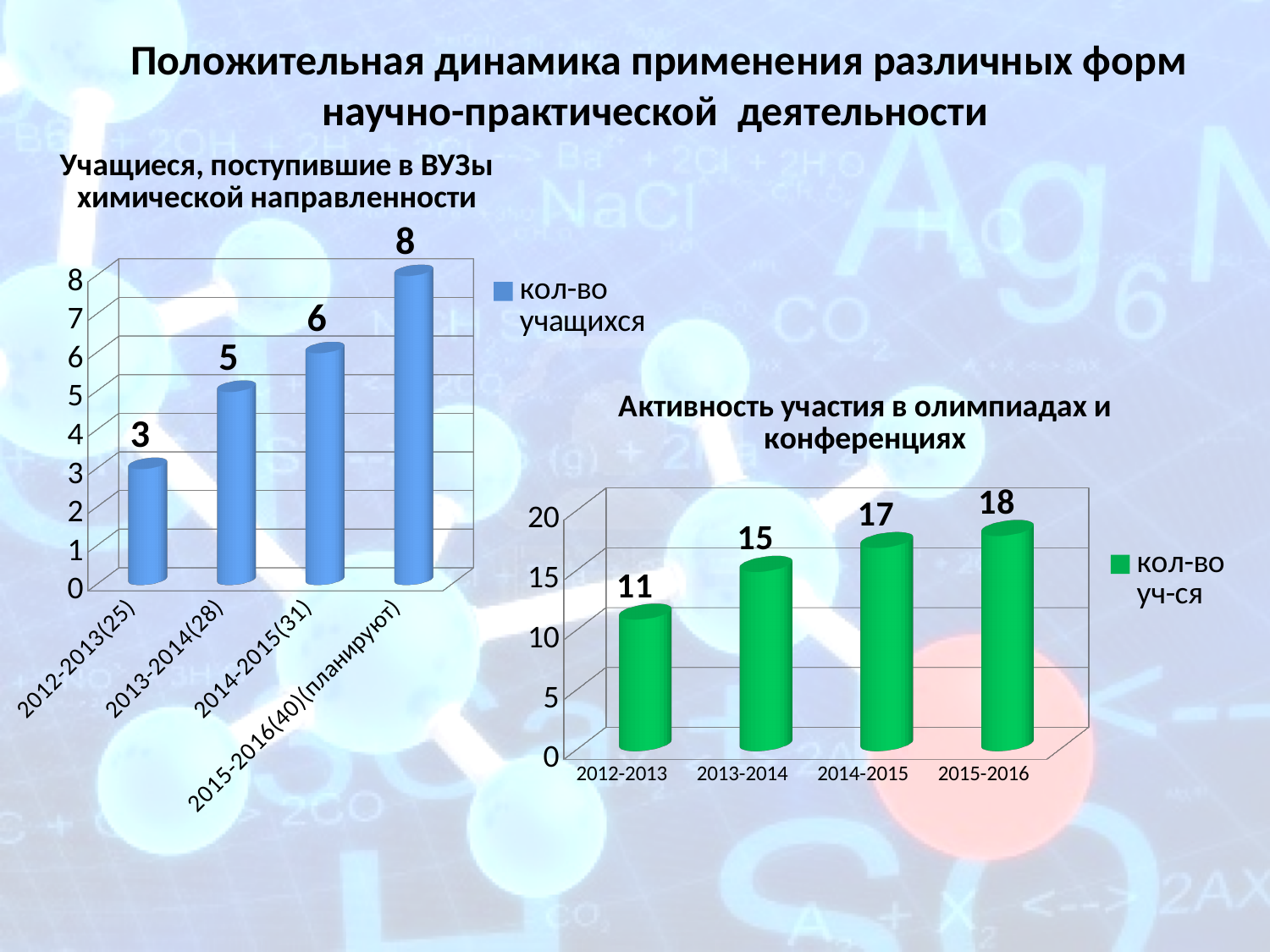
In the chart 'Активность участия в олимпиадах и конференциях', what is the legend entry? кол-во уч-ся In the chart 'Активность участия в олимпиадах и конференциях', what is the difference between the values for 2015-2016 and 2012-2013? 7 In the chart 'Учащиеся, поступившие в ВУЗы химической направленности', which category has the highest value? 2015-2016(40)(планируют) In the chart 'Активность участия в олимпиадах и конференциях', which is larger, the value for 2013-2014 or 2015-2016? 2015-2016 In the chart 'Учащиеся, поступившие в ВУЗы химической направленности', do the values rise or fall from left to right? rise What kind of chart is 'Активность участия в олимпиадах и конференциях'? bar chart In the chart 'Учащиеся, поступившие в ВУЗы химической направленности', what is the value for 2013-2014(28)? 5 In the chart 'Учащиеся, поступившие в ВУЗы химической направленности', what is the difference between the values for 2015-2016(40)(планируют) and 2012-2013(25)? 5 In the chart 'Активность участия в олимпиадах и конференциях', what is the value for 2014-2015? 17 In the chart 'Учащиеся, поступившие в ВУЗы химической направленности', which category has the lowest value? 2012-2013(25) In the chart 'Учащиеся, поступившие в ВУЗы химической направленности', how many categories are shown? 4 In the chart 'Активность участия в олимпиадах и конференциях', what is the value for 2012-2013? 11